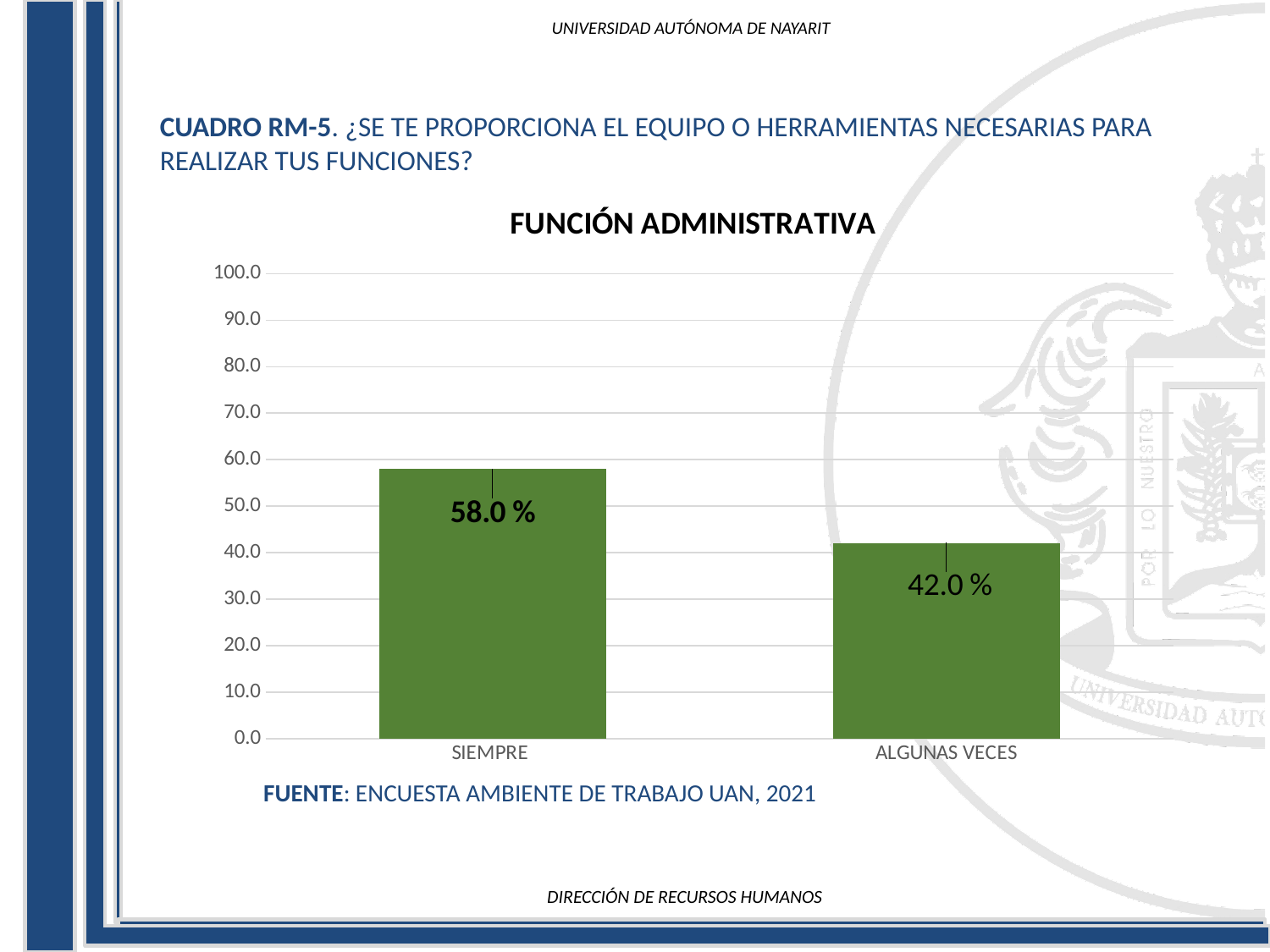
What is the value for ALGUNAS VECES? 42.0 % What is the value for SIEMPRE? 58.0 % Which category has the lowest value? ALGUNAS VECES What is the title of the chart? FUNCIÓN ADMINISTRATIVA What is the highest value shown on the y axis? 100.0 Is the value for ALGUNAS VECES greater or less than 50.0? less Which category has the highest value? SIEMPRE Which is larger, the value for SIEMPRE or the value for ALGUNAS VECES? SIEMPRE Is the value for SIEMPRE greater or less than 50.0? greater How many categories are shown on the x axis? 2 What kind of chart is shown? bar chart What is the difference between the values for SIEMPRE and ALGUNAS VECES? 16.0 %